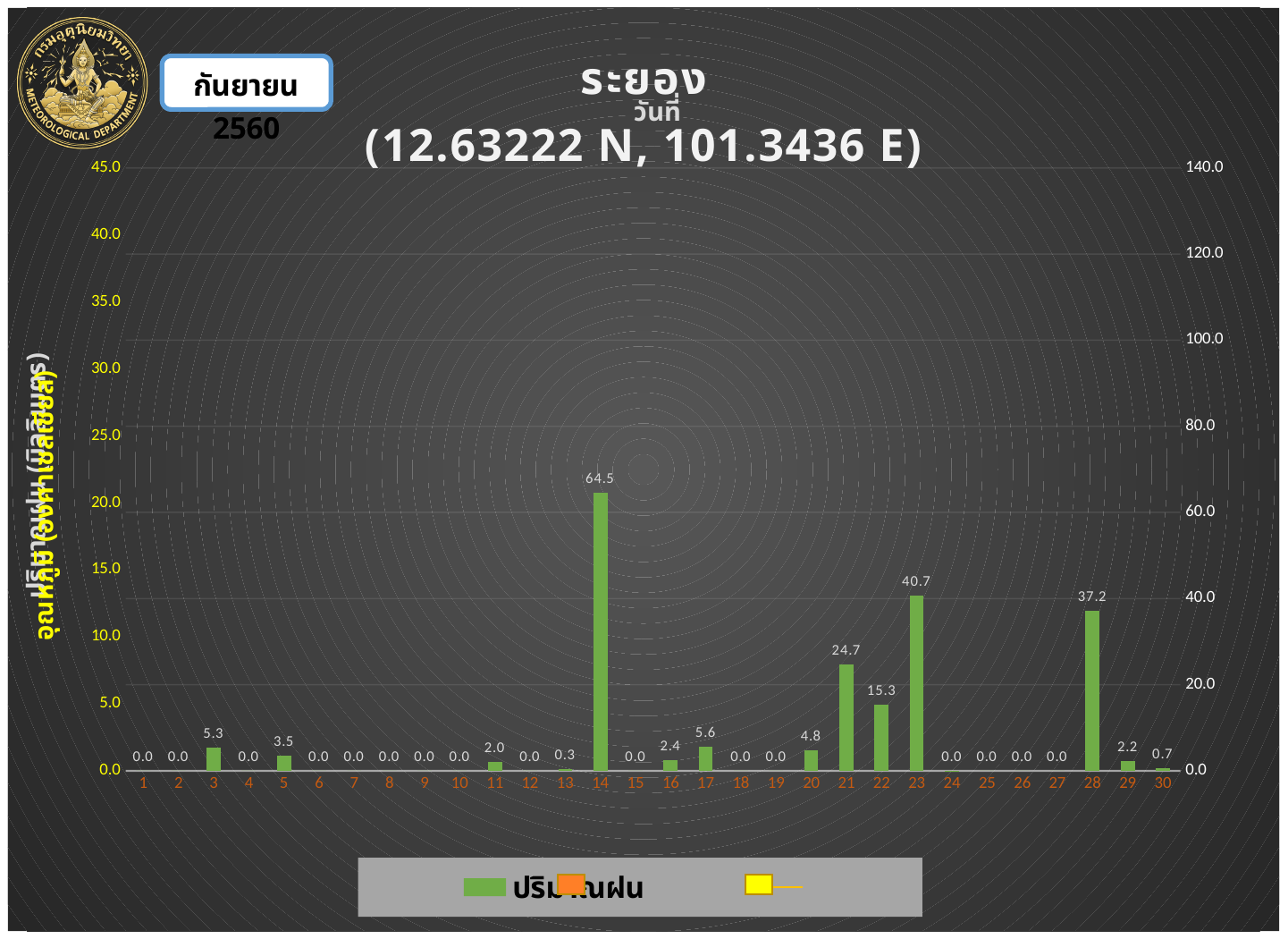
What is the rainfall value shown for day 23? 40.7 Which day has the highest rainfall value? 14 What is the rainfall value shown for day 14? 64.5 What coordinates are given in the chart title? 12.63222 N, 101.3436 E Which has the larger rainfall value, day 3 or day 5? day 3 How many days are shown on the x axis? 30 What is the rainfall value shown for day 21? 24.7 What is the rainfall value shown for day 28? 37.2 Which has the larger rainfall value, day 28 or day 21? day 28 What is the difference between the rainfall values for day 14 and day 23? 23.8 What is the difference between the rainfall values for day 21 and day 22? 9.4 What kind of chart is shown on the slide? bar chart